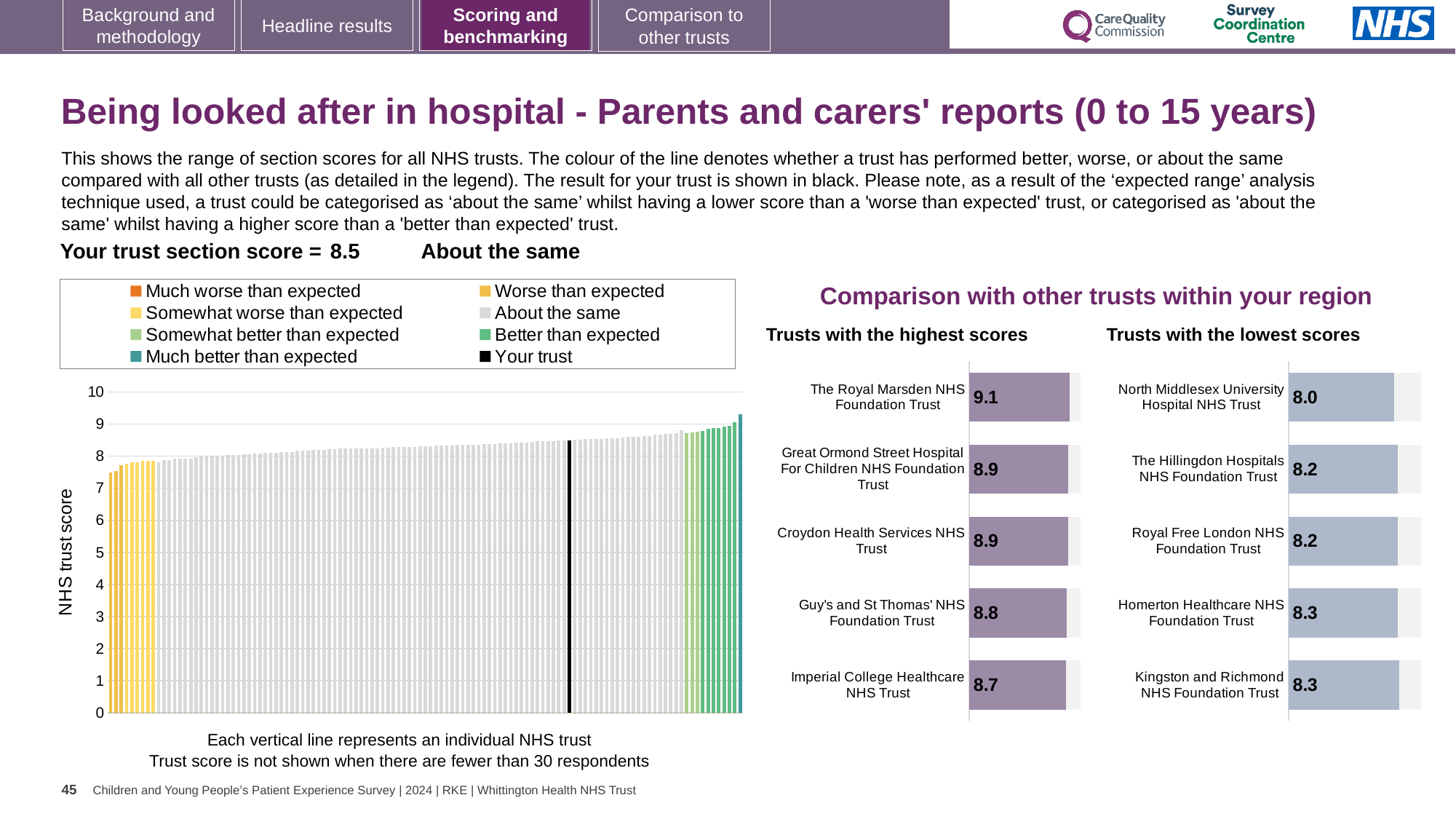
How many entries does the legend of the large chart on the left list? 8 In the 'Trusts with the highest scores' chart, what is the score for The Royal Marsden NHS Foundation Trust? 9.1 In the 'Trusts with the highest scores' chart, what is the score for Imperial College Healthcare NHS Trust? 8.7 In the 'Trusts with the lowest scores' chart, which trust has the lowest score? North Middlesex University Hospital NHS Trust In the 'Trusts with the lowest scores' chart, what is the score for Homerton Healthcare NHS Foundation Trust? 8.3 In the 'Trusts with the lowest scores' chart, what is the difference between the scores of Kingston and Richmond NHS Foundation Trust and North Middlesex University Hospital NHS Trust? 0.3 In the 'Trusts with the highest scores' chart, which trust has the highest score? The Royal Marsden NHS Foundation Trust In the 'Trusts with the lowest scores' chart, what is the score for North Middlesex University Hospital NHS Trust? 8.0 Which has a higher score: Guy's and St Thomas' NHS Foundation Trust in the highest scores chart, or The Hillingdon Hospitals NHS Foundation Trust in the lowest scores chart? Guy's and St Thomas' NHS Foundation Trust In the large chart on the left showing all NHS trusts, is the value for the black 'Your trust' bar greater or less than 8? greater How many trusts are shown in the 'Trusts with the lowest scores' chart? 5 In the 'Trusts with the highest scores' chart, what is the difference between the scores of The Royal Marsden NHS Foundation Trust and Imperial College Healthcare NHS Trust? 0.4